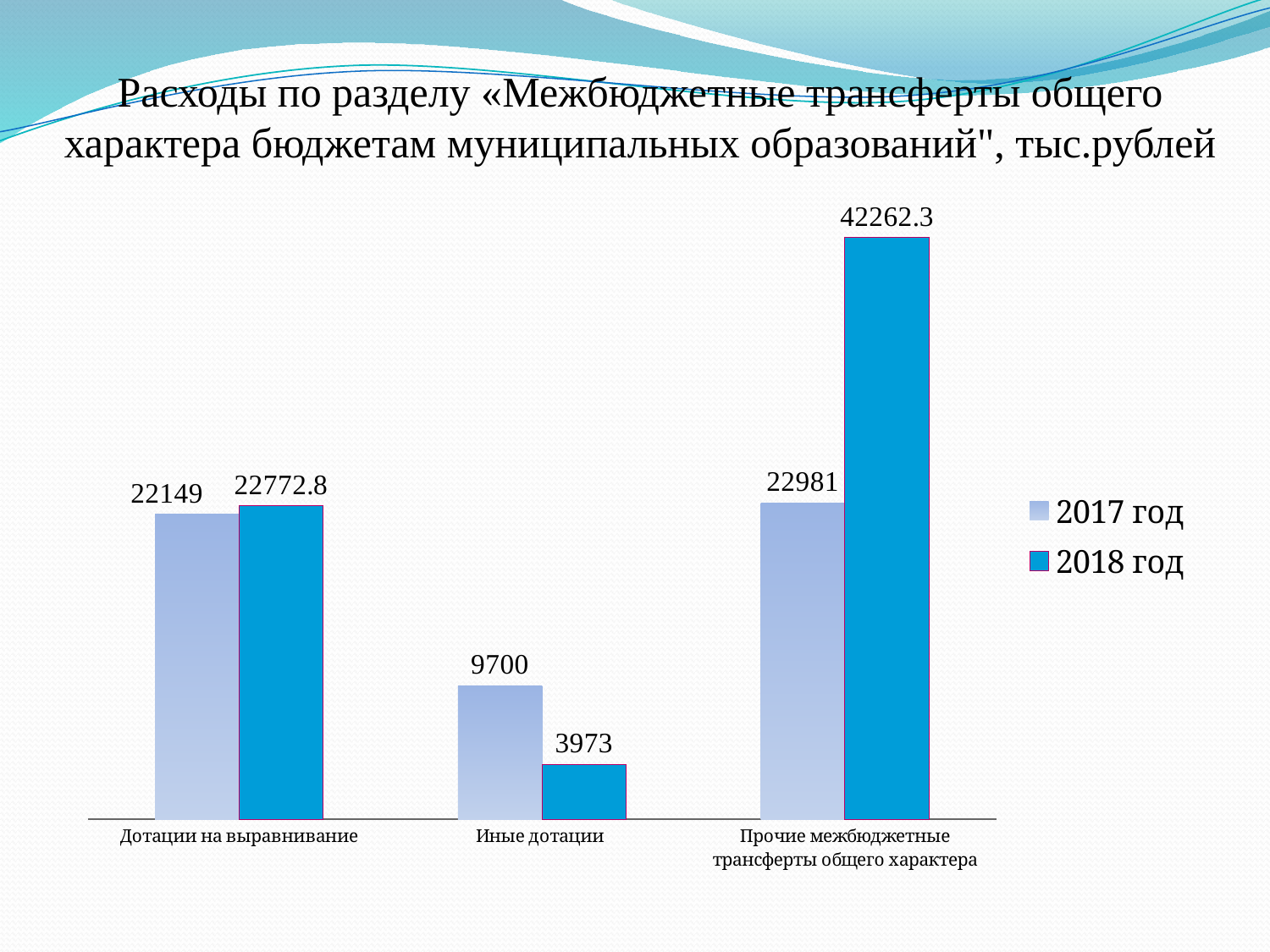
What is the value for Дотации на выравнивание in 2017 год? 22149 What is the value for Иные дотации in 2018 год? 3973 How many categories are shown on the x axis? 3 What is the difference between the 2017 год and 2018 год values for Иные дотации? 5727 How many series does the legend list? 2 For Иные дотации, which year has the larger value, 2017 год or 2018 год? 2017 год What is the value for Прочие межбюджетные трансферты общего характера in 2018 год? 42262.3 Which category has the lowest value in the 2017 год series? Иные дотации What kind of chart is shown on the slide? Bar chart Which category has the highest value in the 2018 год series? Прочие межбюджетные трансферты общего характера What is the value for Дотации на выравнивание in 2018 год? 22772.8 What is the difference between the 2018 год and 2017 год values for Прочие межбюджетные трансферты общего характера? 19281.3